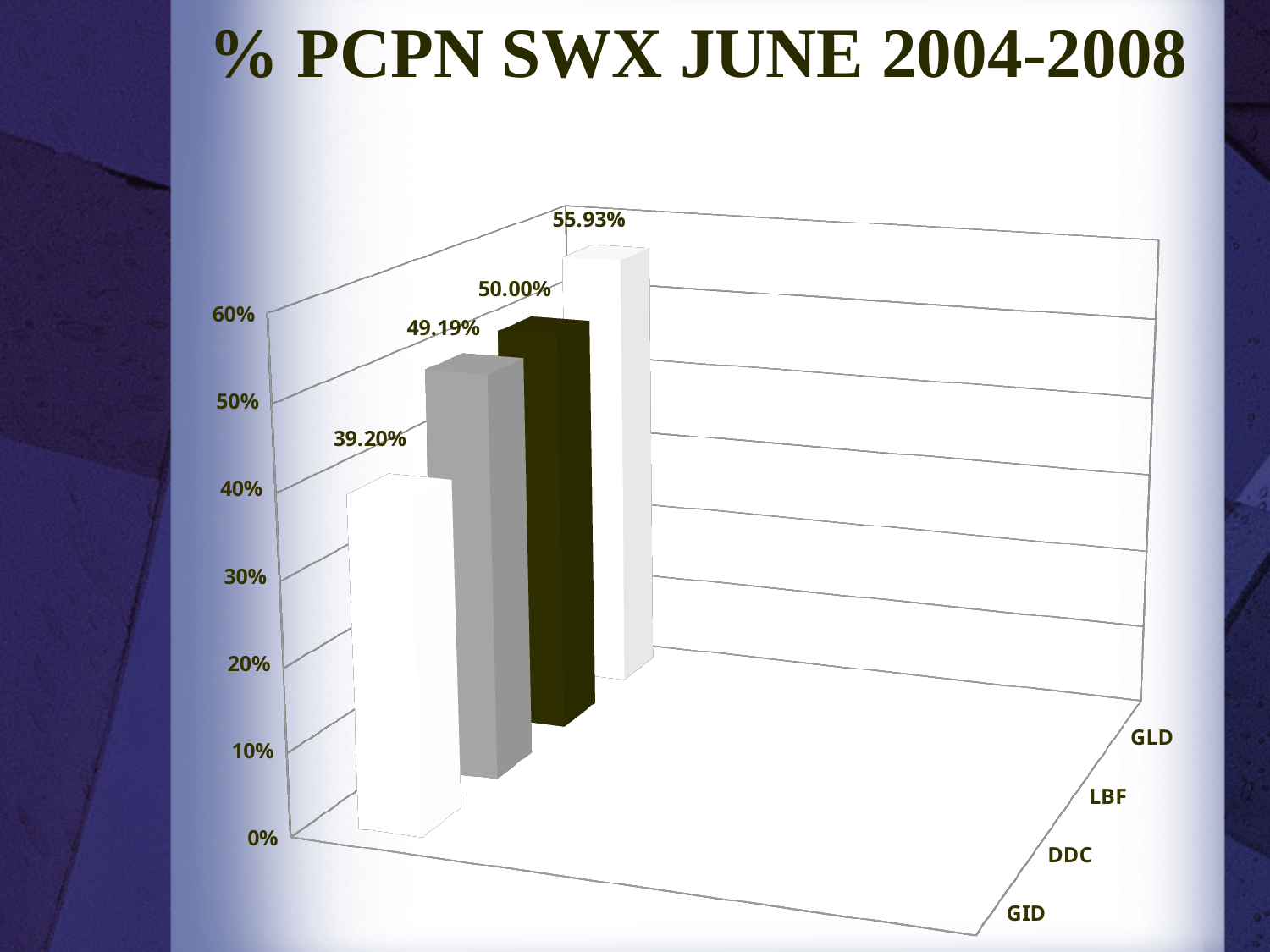
What is the value for GLD? 55.93% How many categories are shown in the chart? 4 What is the value for GID? 39.20% What kind of chart is shown on the slide? bar chart Which category has the highest value? GLD Which is larger, the value for DDC or the value for GLD? GLD What is the value for DDC? 49.19% Is the value for GID greater or less than 40%? less What is the value for LBF? 50.00% Which category has the lowest value? GID What is the title of the chart? % PCPN SWX JUNE 2004-2008 What is the difference between the values for GLD and GID? 16.73%